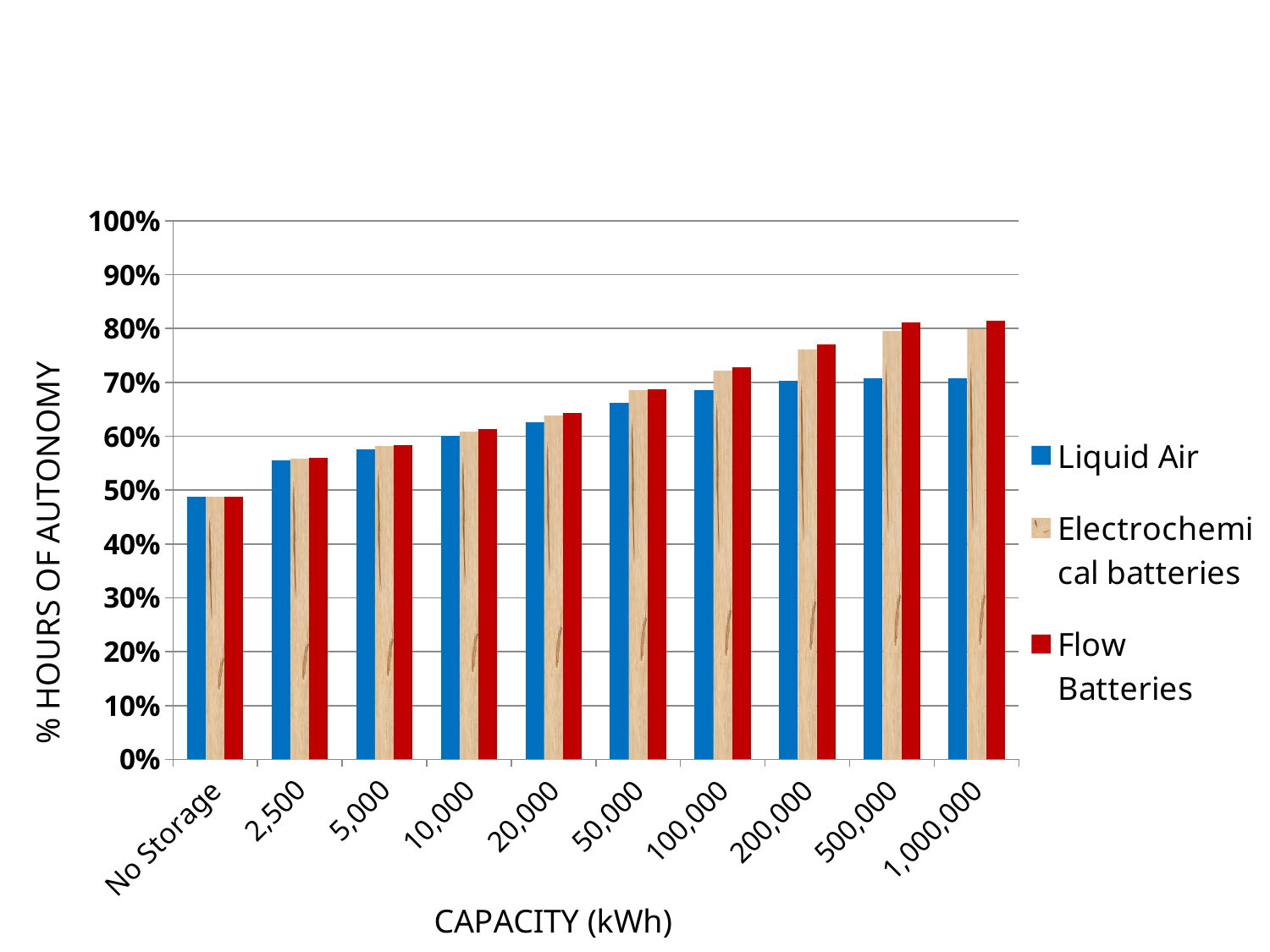
How many series does the legend list? 3 Which series has the lowest value at 200,000 kWh? Liquid Air How many capacity categories are shown on the x axis? 10 Is the value for Flow Batteries at 500,000 kWh greater or less than 80%? greater Is the value for Electrochemical batteries at 200,000 kWh greater or less than 70%? greater Is the value for Liquid Air at 1,000,000 kWh greater or less than 60%? greater Which capacity category has the lowest value for Liquid Air? No Storage What is the title of the y axis? % HOURS OF AUTONOMY At 500,000 kWh, which is larger: Flow Batteries or Liquid Air? Flow Batteries What kind of chart is shown on the slide? bar chart Do the Liquid Air values rise or fall as capacity increases along the x axis? rise